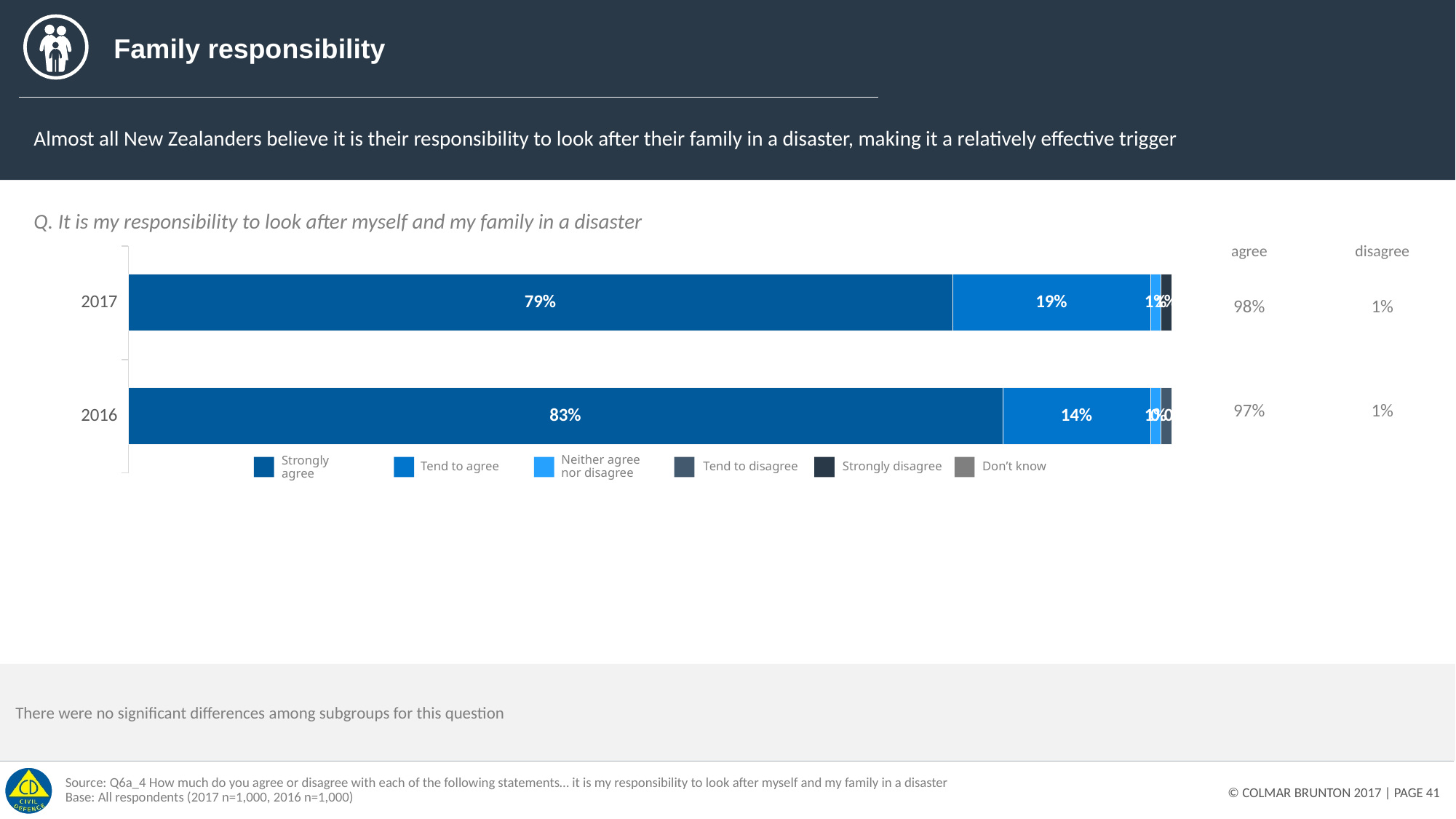
What percentage of respondents strongly agreed in 2017? 79% What is the difference between the 'Strongly agree' percentages for 2016 and 2017? 4 percentage points What is the total disagree figure shown for 2016? 1% How many years are shown in the chart? 2 What percentage of respondents tended to agree in 2017? 19% What type of chart is shown on the slide? Stacked bar chart Which year had the higher 'Strongly agree' percentage, 2017 or 2016? 2016 What percentage of respondents tended to agree in 2016? 14% What percentage of respondents strongly agreed in 2016? 83% What is the total agree figure shown for 2017? 98% What is the difference between the 'Tend to agree' percentages for 2017 and 2016? 5 percentage points How many series does the legend list? 6